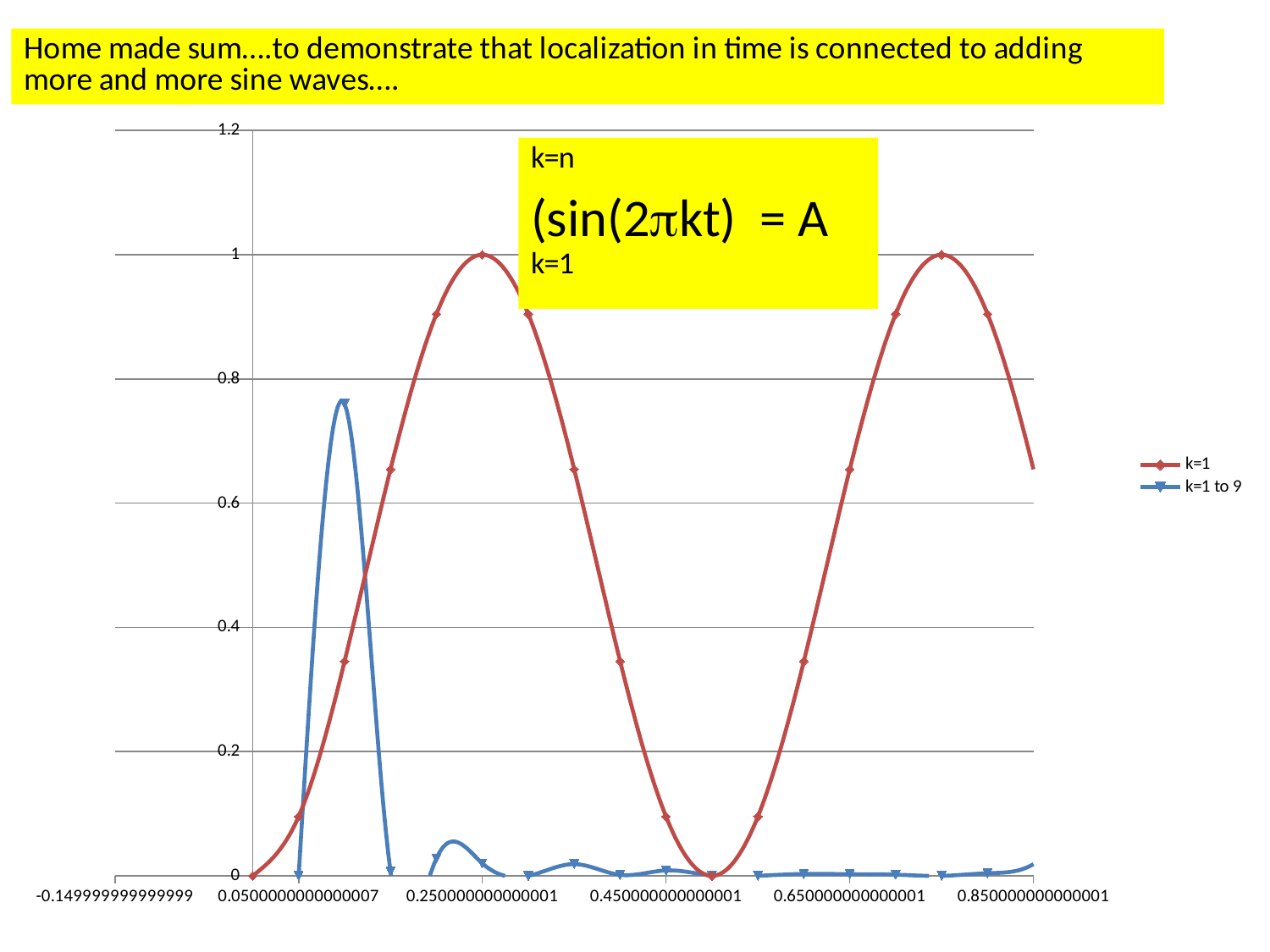
What are the two series named in the chart legend? k=1 and k=1 to 9 What is the maximum value reached by the k=1 series? 1 Is the peak value of the k=1 to 9 series greater or less than 0.6? greater What colour is the line for the k=1 series? red Is the peak value of the k=1 to 9 series greater or less than 0.8? less Which series reaches a higher peak value, k=1 or k=1 to 9? k=1 What is the highest value shown on the vertical axis? 1.2 What kind of chart is shown on the slide? line chart What is the minimum value reached by the k=1 series? 0 After its peak near the left of the chart, does the k=1 to 9 series rise or fall as it moves to the right? fall How many series does the chart legend list? 2 Is the value of the k=1 series at x = 0.45 greater or less than 0.2? less